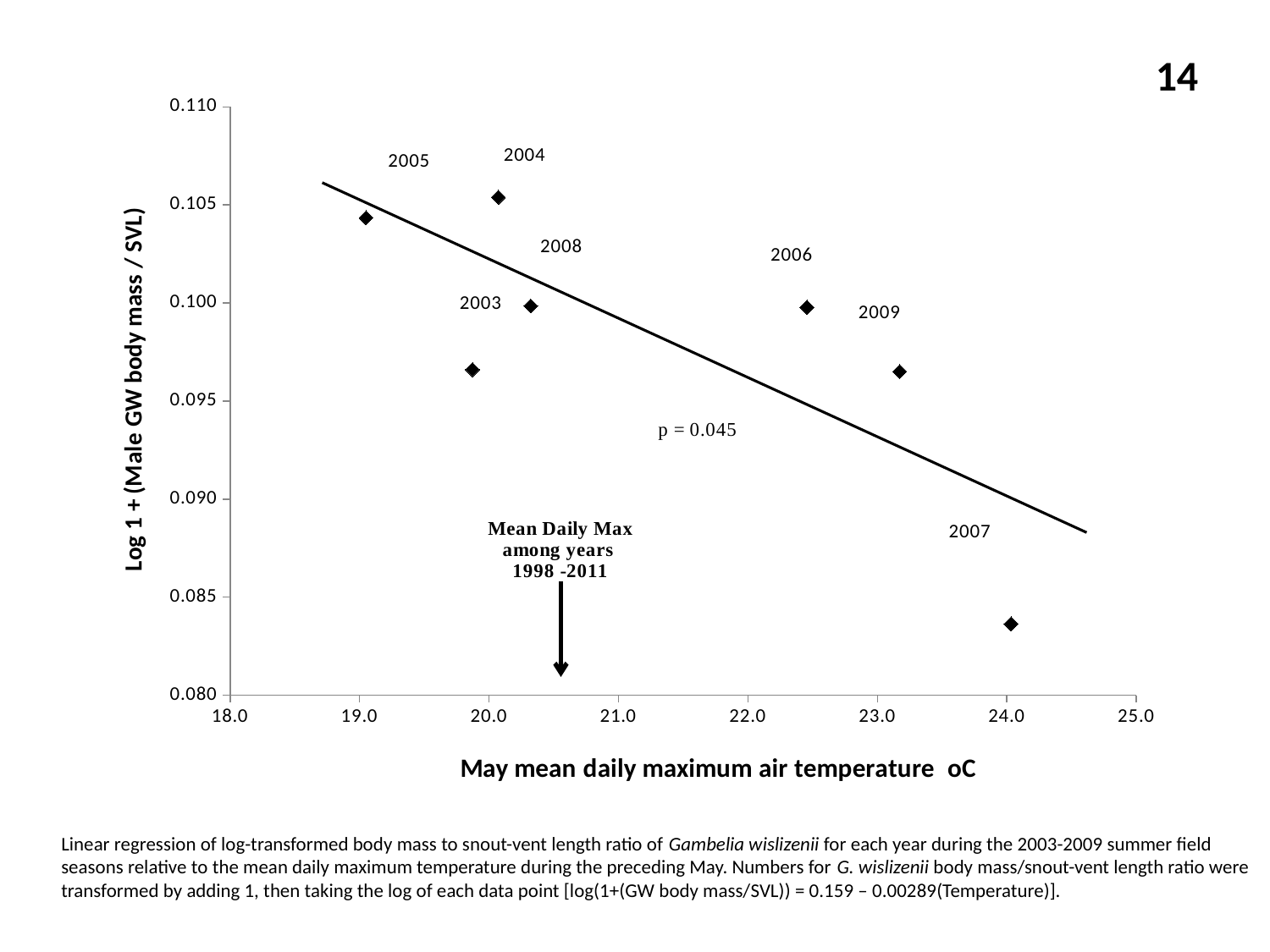
How many data points (years) are plotted on the chart? 7 Is the May mean daily maximum air temperature for 2005 greater or less than 20.0? less What kind of chart is shown on the slide? scatter plot Do the values generally rise or fall as May mean daily maximum air temperature increases? fall Which year has a higher Log 1 + (Male GW body mass / SVL) value, 2006 or 2009? 2006 Which year has the lowest Log 1 + (Male GW body mass / SVL) value? 2007 What p-value is printed on the chart? p = 0.045 Is the Log 1 + (Male GW body mass / SVL) value for 2007 greater or less than 0.090? less Is the Log 1 + (Male GW body mass / SVL) value for 2003 greater or less than 0.100? less Which year has the highest Log 1 + (Male GW body mass / SVL) value? 2004 Which year has a higher Log 1 + (Male GW body mass / SVL) value, 2004 or 2003? 2004